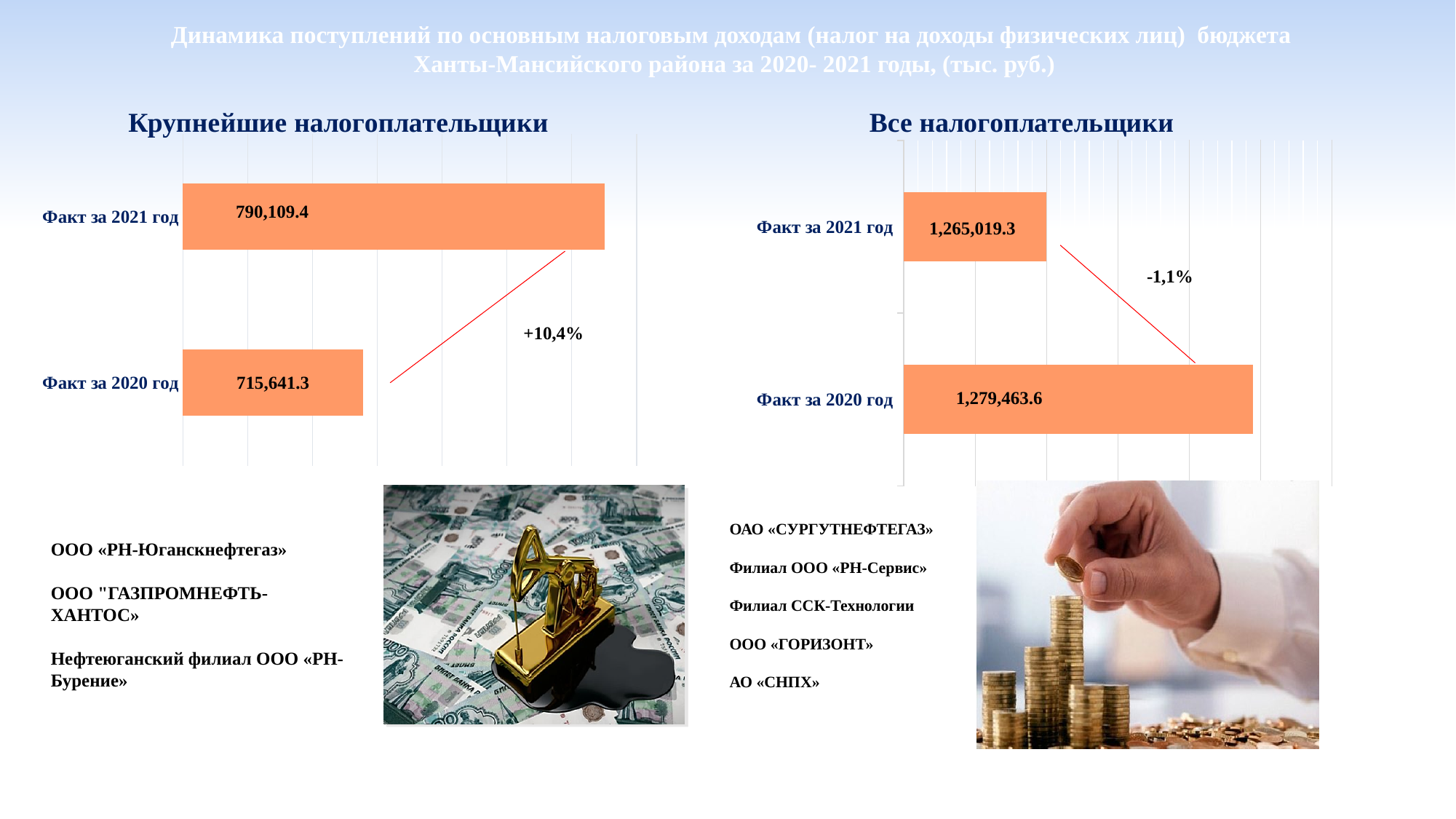
In the 'Крупнейшие налогоплательщики' chart, what is the difference between the 2021 and 2020 values? 74,468.1 In the 'Все налогоплательщики' chart, which category has the lower value? Факт за 2021 год In the 'Крупнейшие налогоплательщики' chart, what is the value for 'Факт за 2021 год'? 790,109.4 What percentage change is annotated on the 'Крупнейшие налогоплательщики' chart? +10,4% In the 'Все налогоплательщики' chart, what is the difference between the 2020 and 2021 values? 14,444.3 In the 'Все налогоплательщики' chart, what is the value for 'Факт за 2021 год'? 1,265,019.3 What type of chart is the 'Все налогоплательщики' chart? bar chart In the 'Крупнейшие налогоплательщики' chart, which category has the higher value? Факт за 2021 год In the 'Все налогоплательщики' chart, is the value for 'Факт за 2020 год' larger or smaller than the value for 'Факт за 2021 год'? larger In the 'Все налогоплательщики' chart, what is the value for 'Факт за 2020 год'? 1,279,463.6 How many categories are shown in the 'Крупнейшие налогоплательщики' chart? 2 In the 'Крупнейшие налогоплательщики' chart, what is the value for 'Факт за 2020 год'? 715,641.3